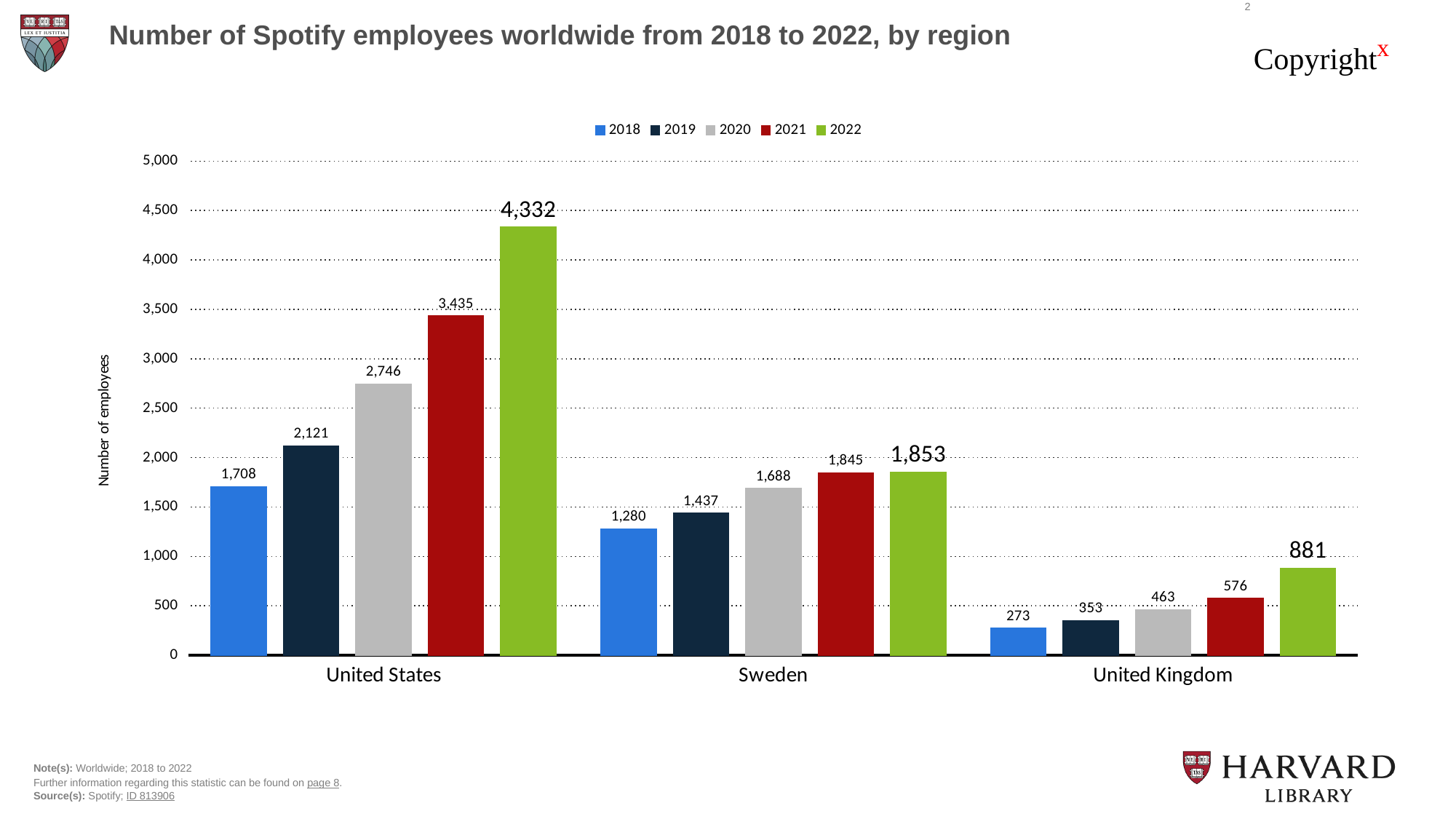
What kind of chart is shown on the slide? Bar chart How many Spotify employees were in the United States in 2022? 4,332 What is the difference between the number of Spotify employees in the United States in 2022 and in 2021? 897 How many series does the legend list? 5 Which is larger: the number of Spotify employees in Sweden in 2020 or in the United Kingdom in 2022? Sweden in 2020 How many regions are shown on the x axis? 3 Which region had the lowest number of Spotify employees in 2019? United Kingdom Which region had the highest number of Spotify employees in 2021? United States What was the number of Spotify employees in Sweden in 2018? 1,280 Do the values for the United Kingdom rise or fall from 2018 to 2022? Rise What was the number of Spotify employees in the United Kingdom in 2020? 463 Is the value for the United States in 2019 greater or less than 2,000? greater